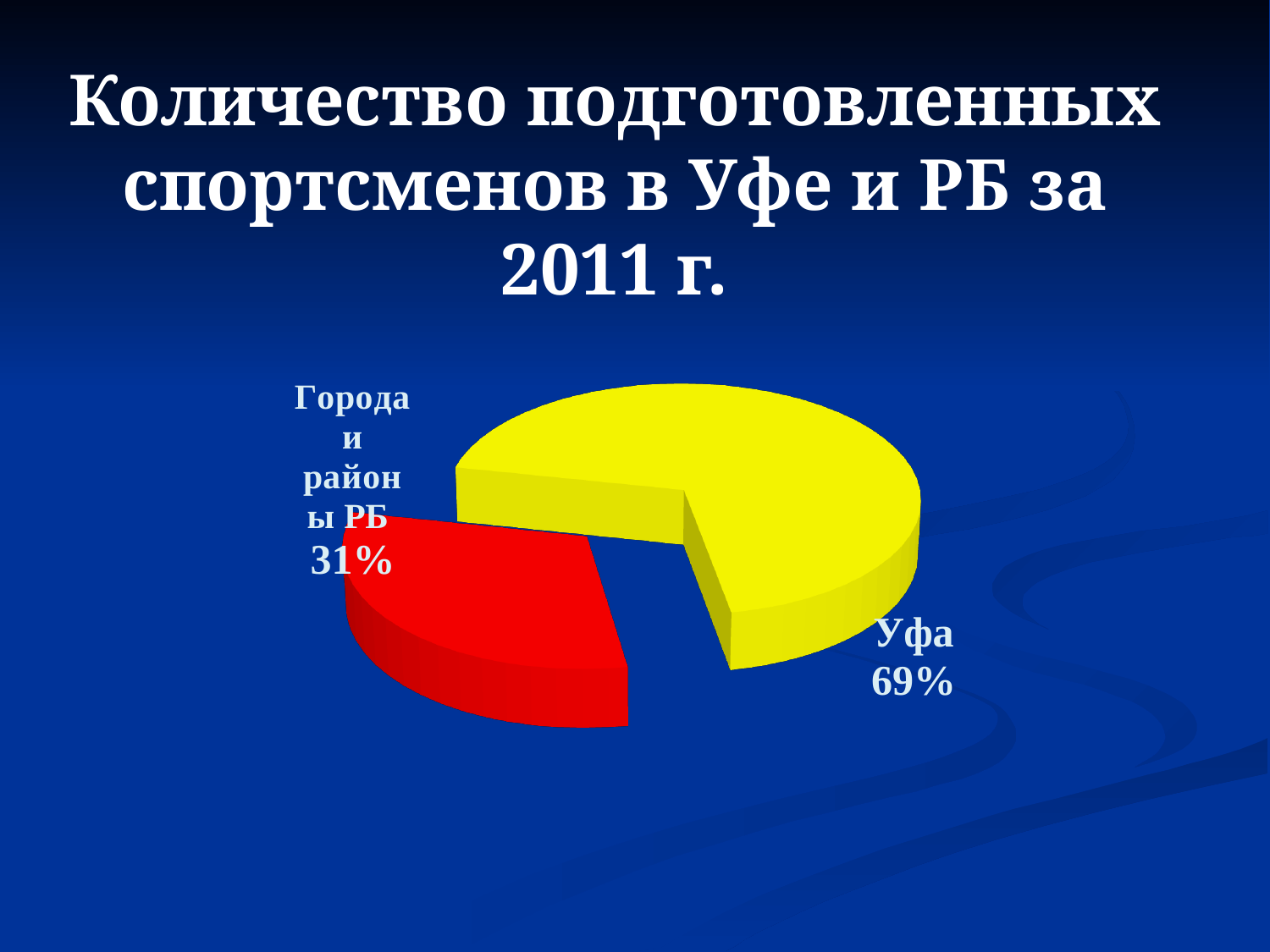
Which slice is the smallest? Города и районы РБ Which slice is the largest? Уфа Which is larger, the share for Уфа or the share for Города и районы РБ? Уфа How many slices does the pie chart have? 2 What share of the pie does Уфа account for? 69% What share of the pie does Города и районы РБ account for? 31% What is the title of the slide? Количество подготовленных спортсменов в Уфе и РБ за 2011 г. What is the difference in percentage points between the Уфа slice and the Города и районы РБ slice? 38 What kind of chart is shown on the slide? Pie chart Is the share for Уфа greater or less than 50%? greater What colour is the Уфа slice? Yellow